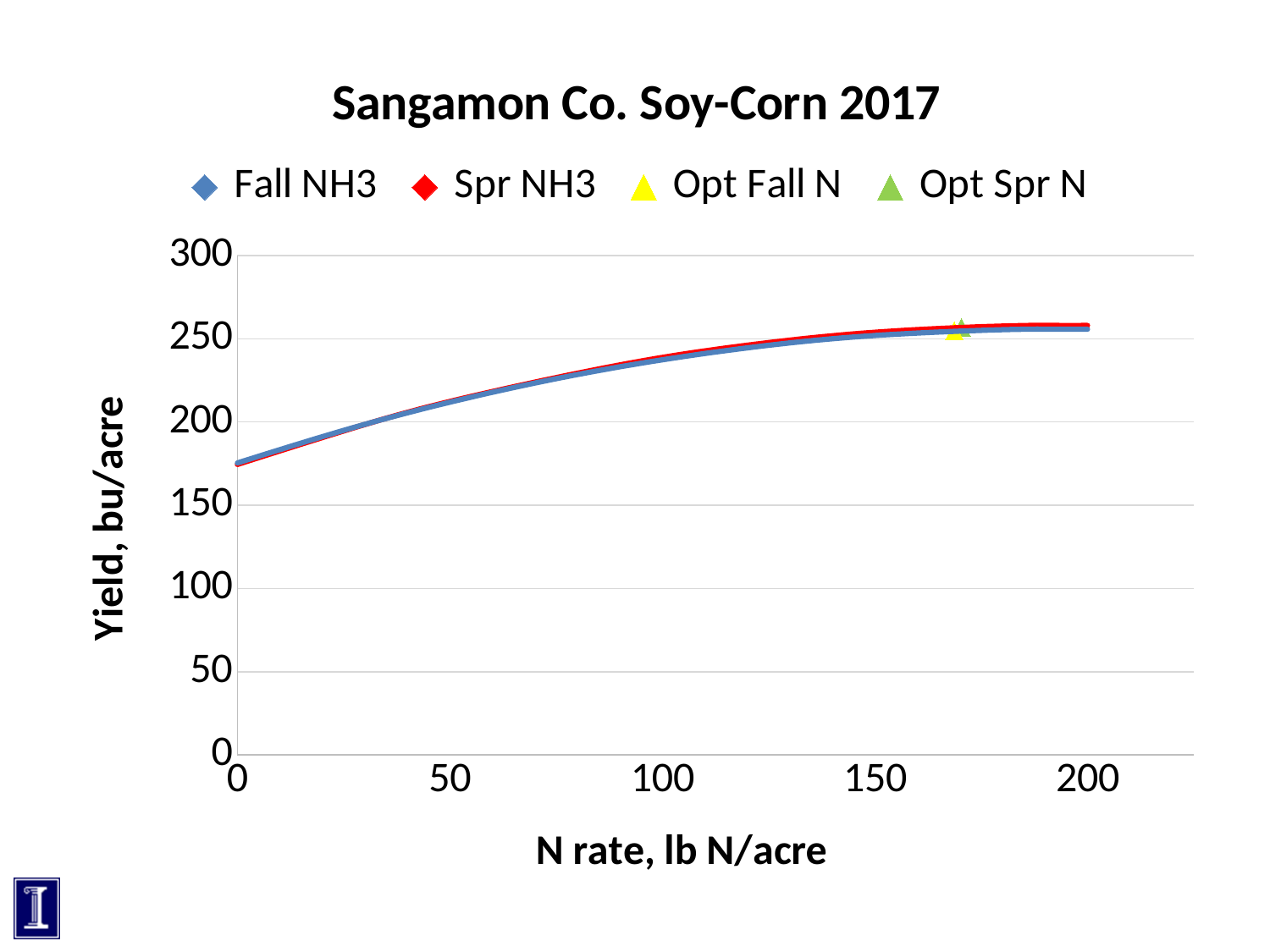
Is the Fall NH3 yield at an N rate of 100 greater or less than 200? greater What kind of chart is this? line chart Is the Spr NH3 yield at an N rate of 100 greater or less than 250? less How many series does the legend list? 4 Is the Fall NH3 yield at an N rate of 0 greater or less than 200? less Does the Fall NH3 yield rise or fall as the N rate increases from 0 to 200? rise What is the label of the y axis? Yield, bu/acre What is the title of the chart? Sangamon Co. Soy-Corn 2017